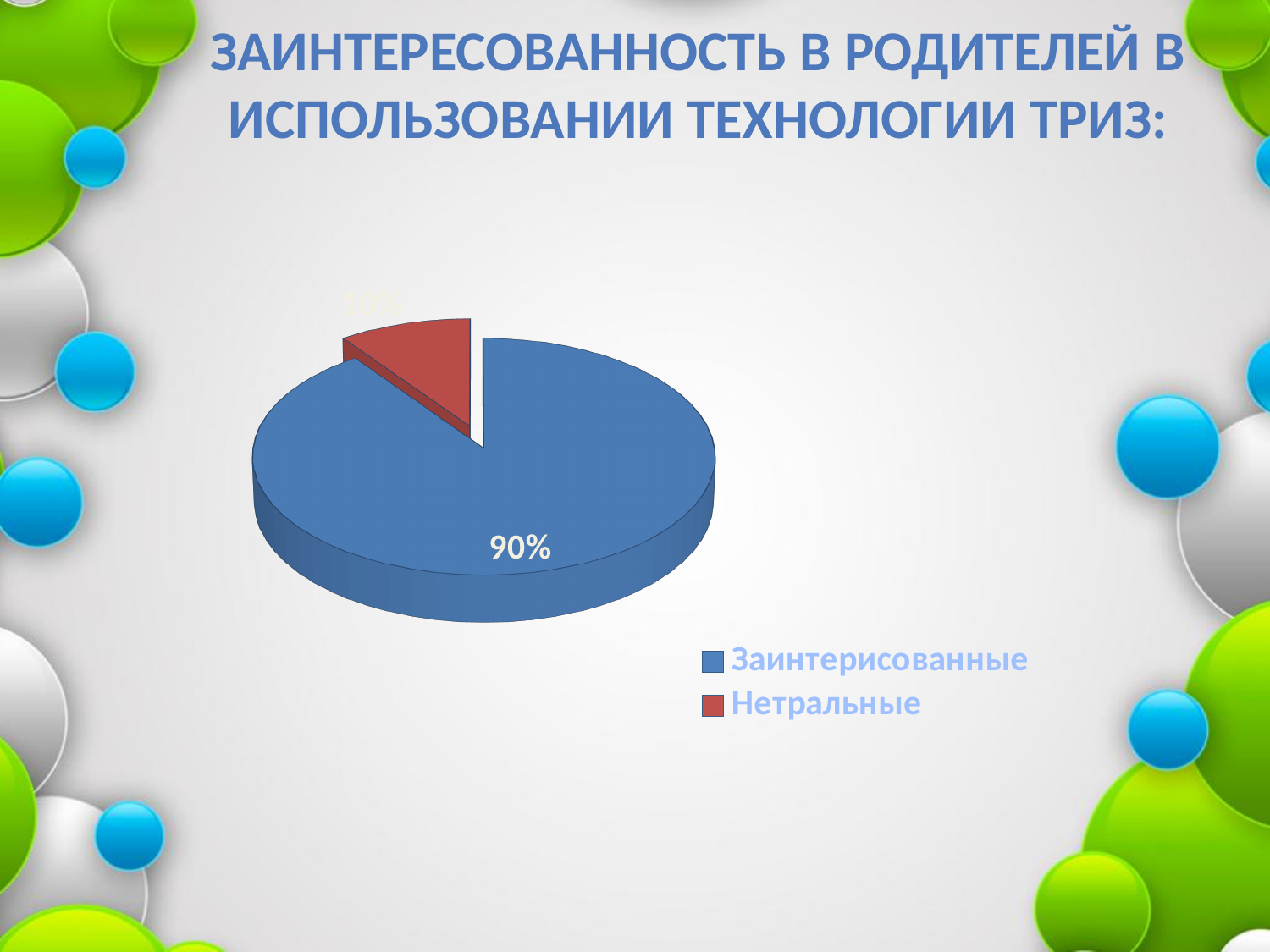
What percentage is shown for the Нетральные slice? 10% What percentage is shown for the Заинтерисованные slice? 90% What share of the pie does the Заинтерисованные slice represent? 90% What colour is the Заинтерисованные slice in the pie chart? blue How many entries does the legend list? 2 Which category has the largest slice of the pie? Заинтерисованные Which category has the smallest slice of the pie? Нетральные What is the title of the slide containing the pie chart? ЗАИНТЕРЕСОВАННОСТЬ В РОДИТЕЛЕЙ В ИСПОЛЬЗОВАНИИ ТЕХНОЛОГИИ ТРИЗ: What kind of chart is shown on the slide? pie chart Which is larger, the Заинтерисованные slice or the Нетральные slice? Заинтерисованные By how many percentage points does the Заинтерисованные slice exceed the Нетральные slice? 80 percentage points How many slices does the pie chart have? 2